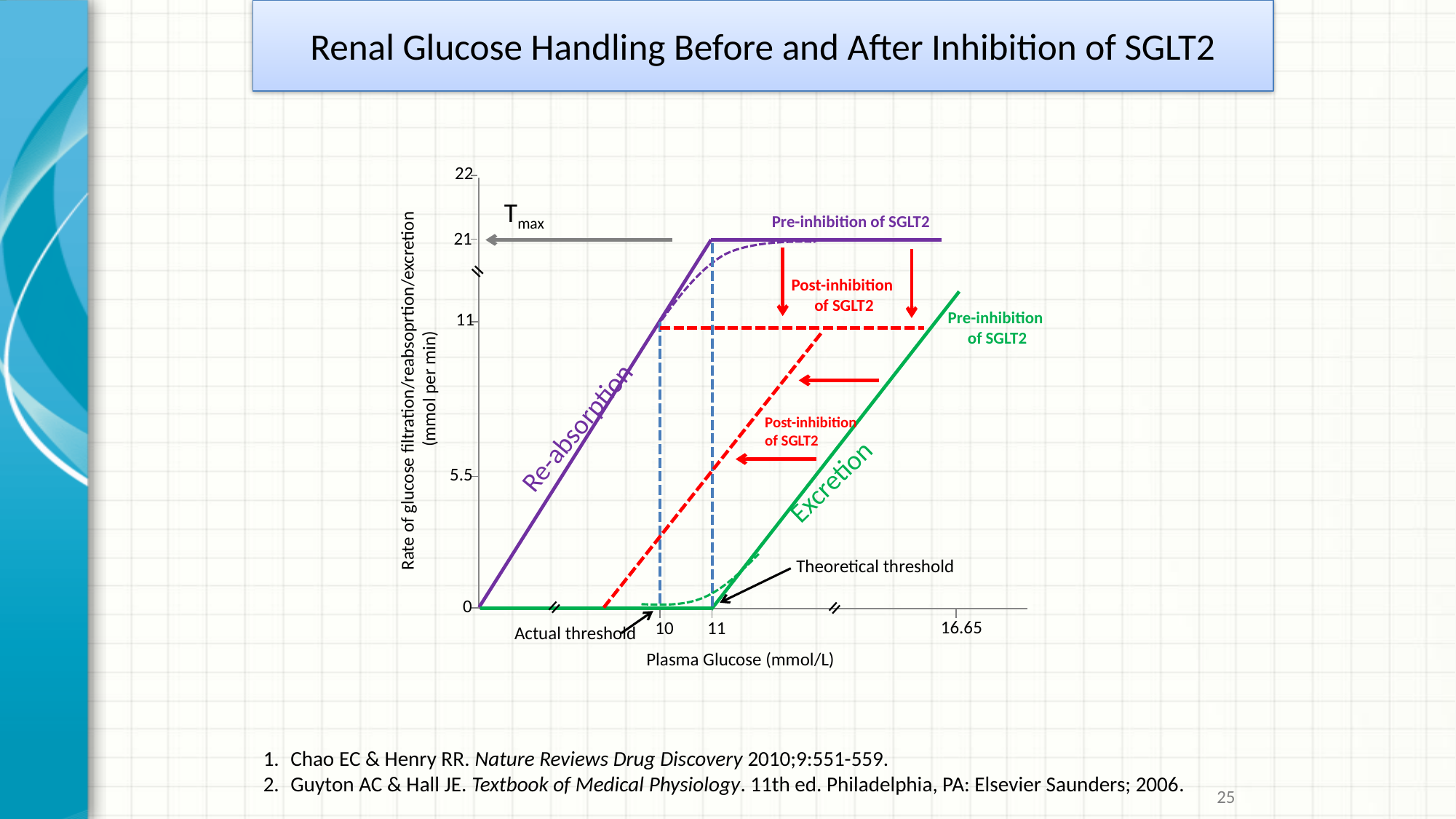
What value on the y axis does the Tmax arrow point to? 21 What colour is the line labelled Re-absorption? purple At a plasma glucose of 16.65, which is larger: the pre-inhibition re-absorption rate or the pre-inhibition excretion rate? pre-inhibition re-absorption How many plasma glucose values are labelled on the x axis? 3 What is the largest plasma glucose value labelled on the x axis? 16.65 Does the pre-inhibition excretion line rise or fall as plasma glucose increases beyond the threshold? rise At what plasma glucose value is the theoretical threshold marked? 11 Is the plateau of the pre-inhibition re-absorption line greater or less than 11? greater At what plasma glucose value is the actual threshold marked? 10 What is the label of the x axis? Plasma Glucose (mmol/L) At what rate does the post-inhibition of SGLT2 re-absorption line (red dashed) plateau? 11 What kind of chart is shown on the slide? line chart